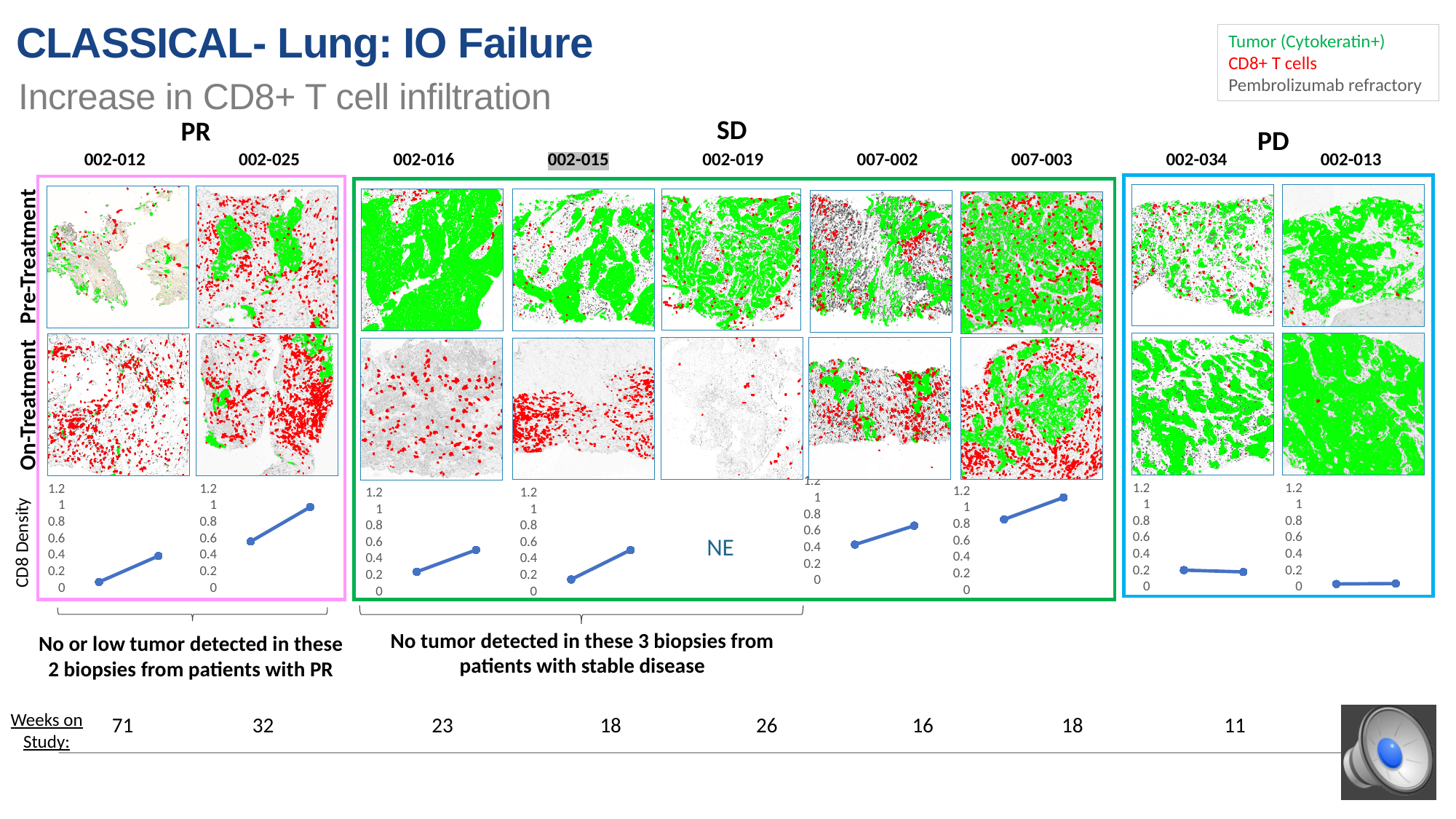
In the CD8 Density chart for patient 002-012, is the pre-treatment value greater or less than 0.2? less In the CD8 Density chart for patient 007-003, does the value rise or fall from pre-treatment to on-treatment? rise What kind of chart is used to show CD8 Density for each patient on this slide? line chart How many data points are plotted in the CD8 Density chart for patient 002-016? 2 In the CD8 Density chart for patient 002-025, is the on-treatment value greater or less than 0.8? greater In the CD8 Density chart for patient 002-034, is the on-treatment value greater or less than 0.4? less What is the label on the y axis of the small charts at the bottom of the image panels? CD8 Density In the CD8 Density chart for patient 002-025, does the value rise or fall from pre-treatment to on-treatment? rise In the CD8 Density chart for patient 002-012, does the value rise or fall from pre-treatment to on-treatment? rise Which patient's CD8 Density chart is marked NE instead of showing plotted data? 002-019